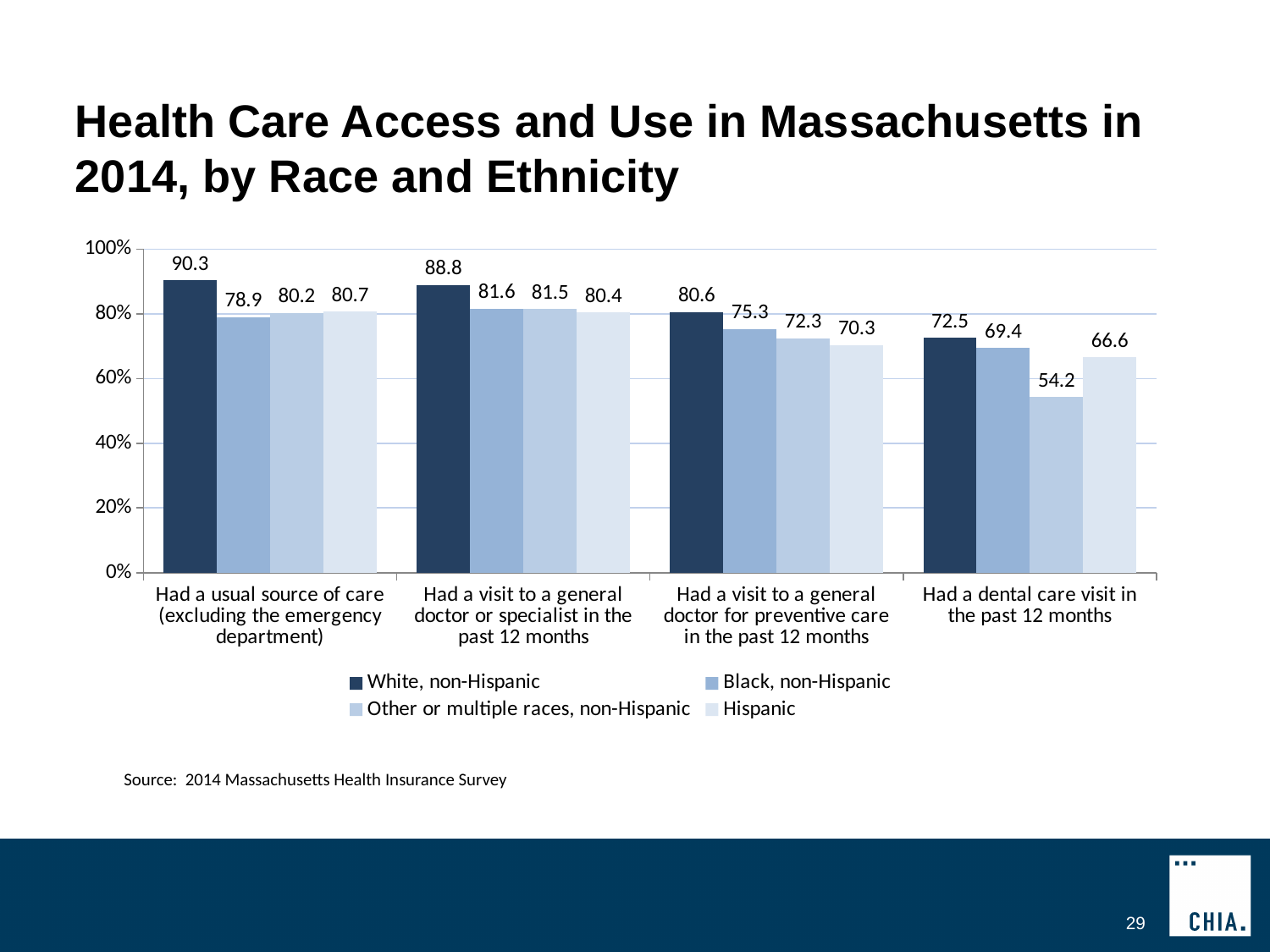
Which group has the highest value in the 'Had a visit to a general doctor or specialist in the past 12 months' category? White, non-Hispanic How many categories are shown on the x axis? 4 What kind of chart is shown on the slide? bar chart What is the difference between the White, non-Hispanic and Black, non-Hispanic values in the 'Had a usual source of care (excluding the emergency department)' category? 11.4 Which is larger: the Hispanic value for 'Had a visit to a general doctor for preventive care in the past 12 months' or the Hispanic value for 'Had a dental care visit in the past 12 months'? Had a visit to a general doctor for preventive care in the past 12 months Is the value for Other or multiple races, non-Hispanic in the 'Had a dental care visit in the past 12 months' category greater or less than 60%? less What is the source cited below the chart? 2014 Massachusetts Health Insurance Survey Which group has the lowest value in the 'Had a dental care visit in the past 12 months' category? Other or multiple races, non-Hispanic What is the value for White, non-Hispanic in the 'Had a usual source of care (excluding the emergency department)' category? 90.3 What is the value for Black, non-Hispanic in the 'Had a visit to a general doctor for preventive care in the past 12 months' category? 75.3 How many series does the legend list? 4 What is the value for Hispanic in the 'Had a dental care visit in the past 12 months' category? 66.6